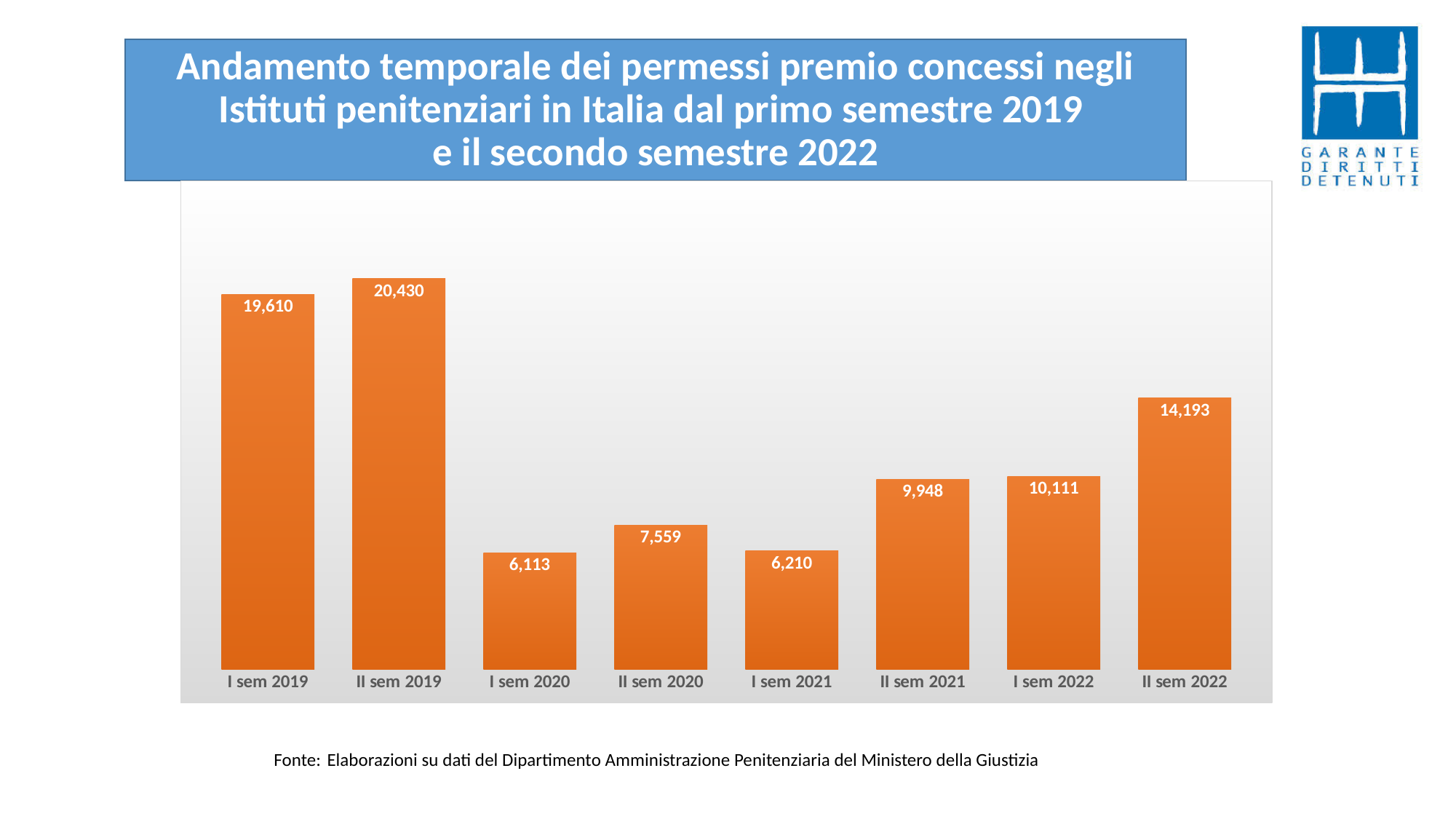
How many semesters are shown on the x axis? 8 What is the value for II sem 2019? 20,430 Which semester has the lowest value? I sem 2020 What is the value for II sem 2022? 14,193 What is the difference between the values for II sem 2019 and I sem 2019? 820 Which semester has the highest value? II sem 2019 Do the values rise or fall from I sem 2021 to II sem 2022? Rise What is the difference between the values for II sem 2022 and I sem 2022? 4,082 What is the value for I sem 2020? 6,113 What colour are the bars in the chart? Orange What kind of chart is shown on the slide? Bar chart Which is larger, the value for II sem 2020 or the value for I sem 2021? II sem 2020